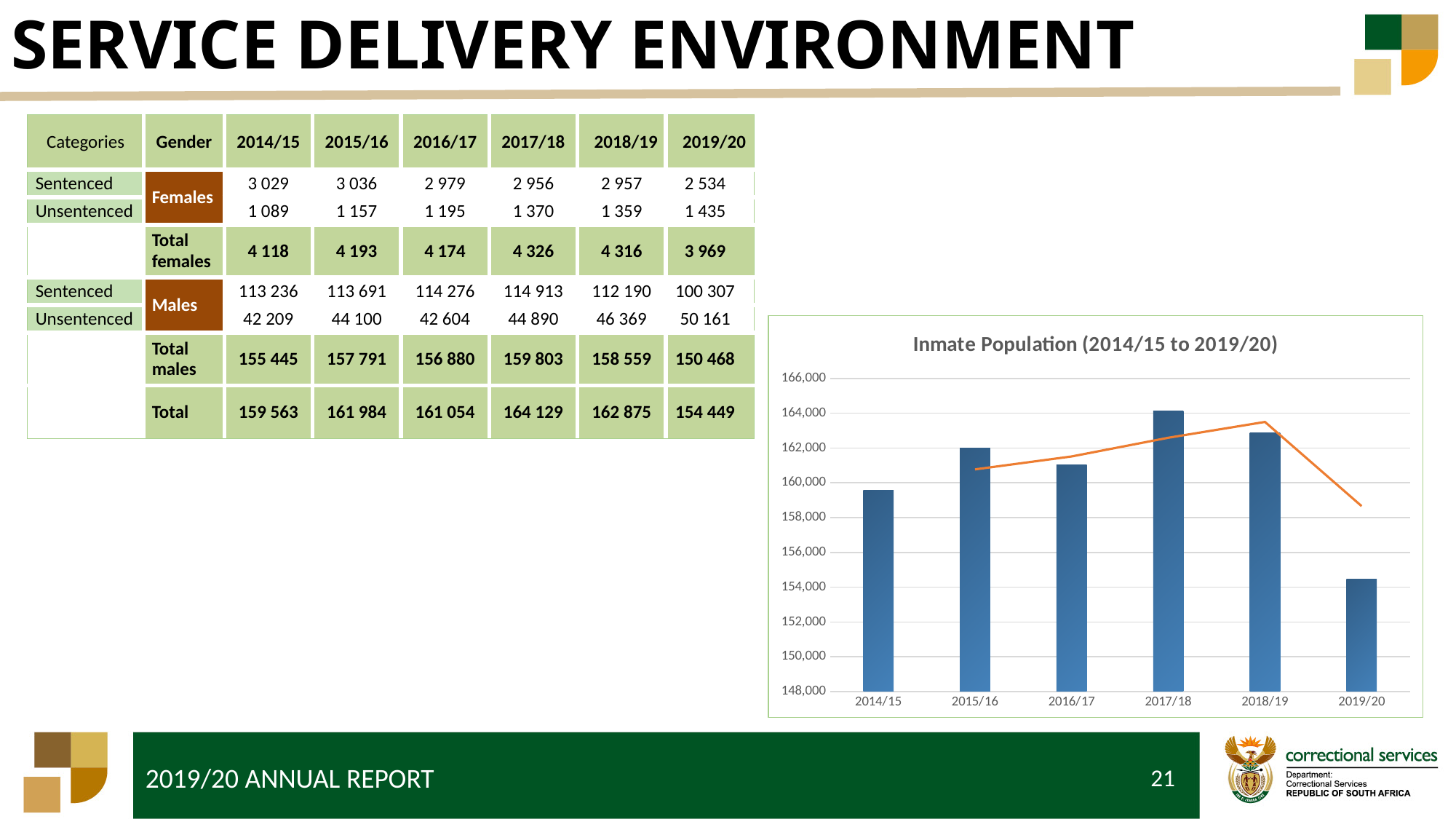
In the Inmate Population chart, is the value for 2019/20 greater or less than 156,000? less What colour is the line drawn over the bars in the Inmate Population chart? orange What kind of chart is the Inmate Population chart? bar chart In the Inmate Population chart, is the value for 2018/19 greater or less than 164,000? less What is the title of the chart on the slide? Inmate Population (2014/15 to 2019/20) How many years are plotted on the x axis of the Inmate Population chart? 6 In the Inmate Population chart, which bar is taller, 2018/19 or 2014/15? 2018/19 In the Inmate Population chart, which year has the tallest bar? 2017/18 In the Inmate Population chart, does the value rise or fall from 2018/19 to 2019/20? fall In the Inmate Population chart, which year has the shortest bar? 2019/20 In the Inmate Population chart, is the value for 2017/18 greater or less than 162,000? greater